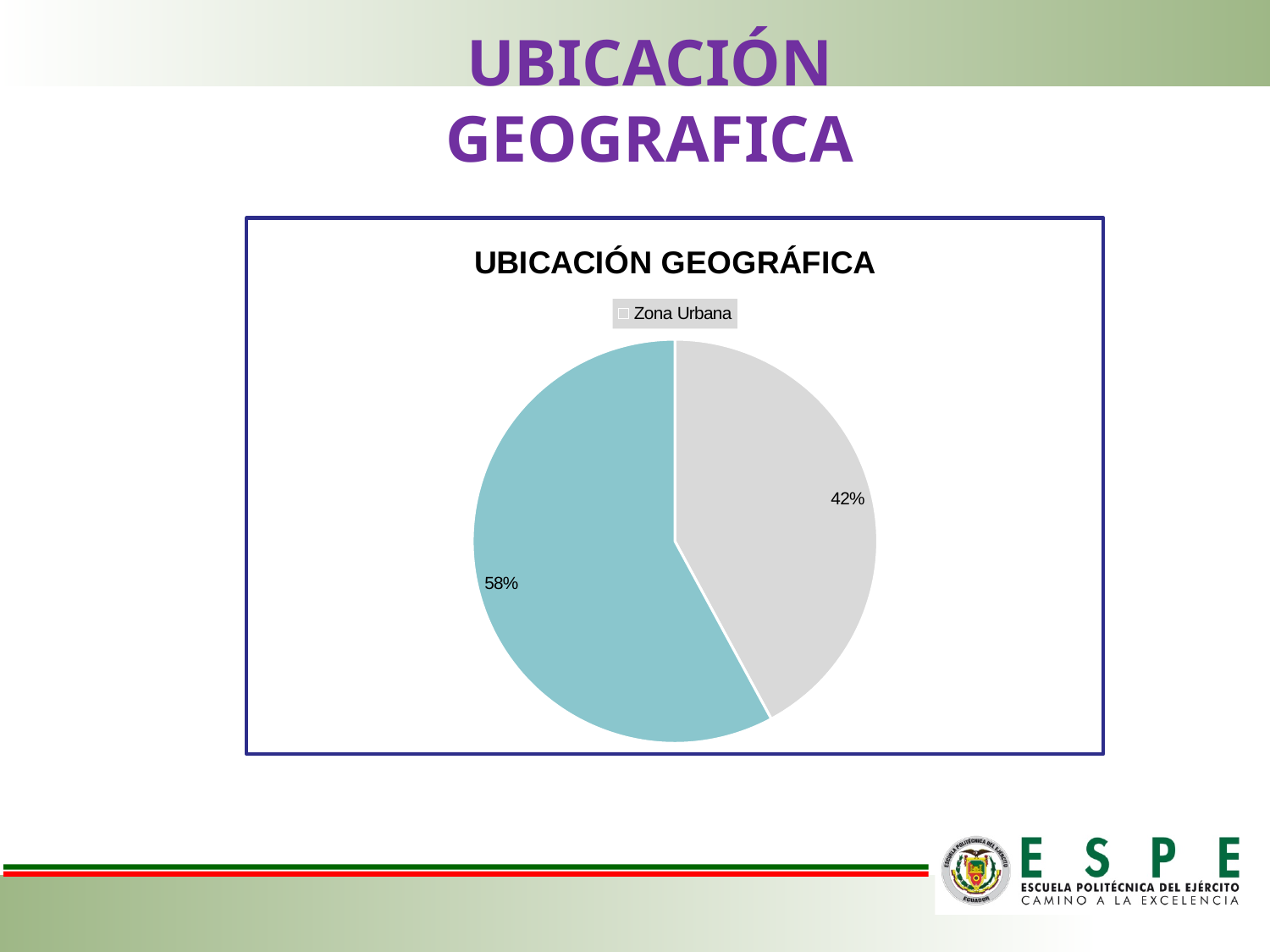
How many entries does the legend list? 1 What is the title of the chart? UBICACIÓN GEOGRÁFICA How many slices does the pie chart have? 2 What kind of chart is shown on the slide? Pie chart What percentage is shown on the teal (blue-green) slice of the pie? 58% Is the Zona Urbana share greater or less than 50%? less What is the value of the largest slice in the pie chart? 58% Which slice is the smallest in the pie chart? Zona Urbana (42%) Which is larger, the Zona Urbana slice or the teal slice? The teal slice What percentage does the Zona Urbana slice represent? 42% Which entry is listed in the legend? Zona Urbana What is the difference in percentage points between the teal slice and the Zona Urbana slice? 16 percentage points